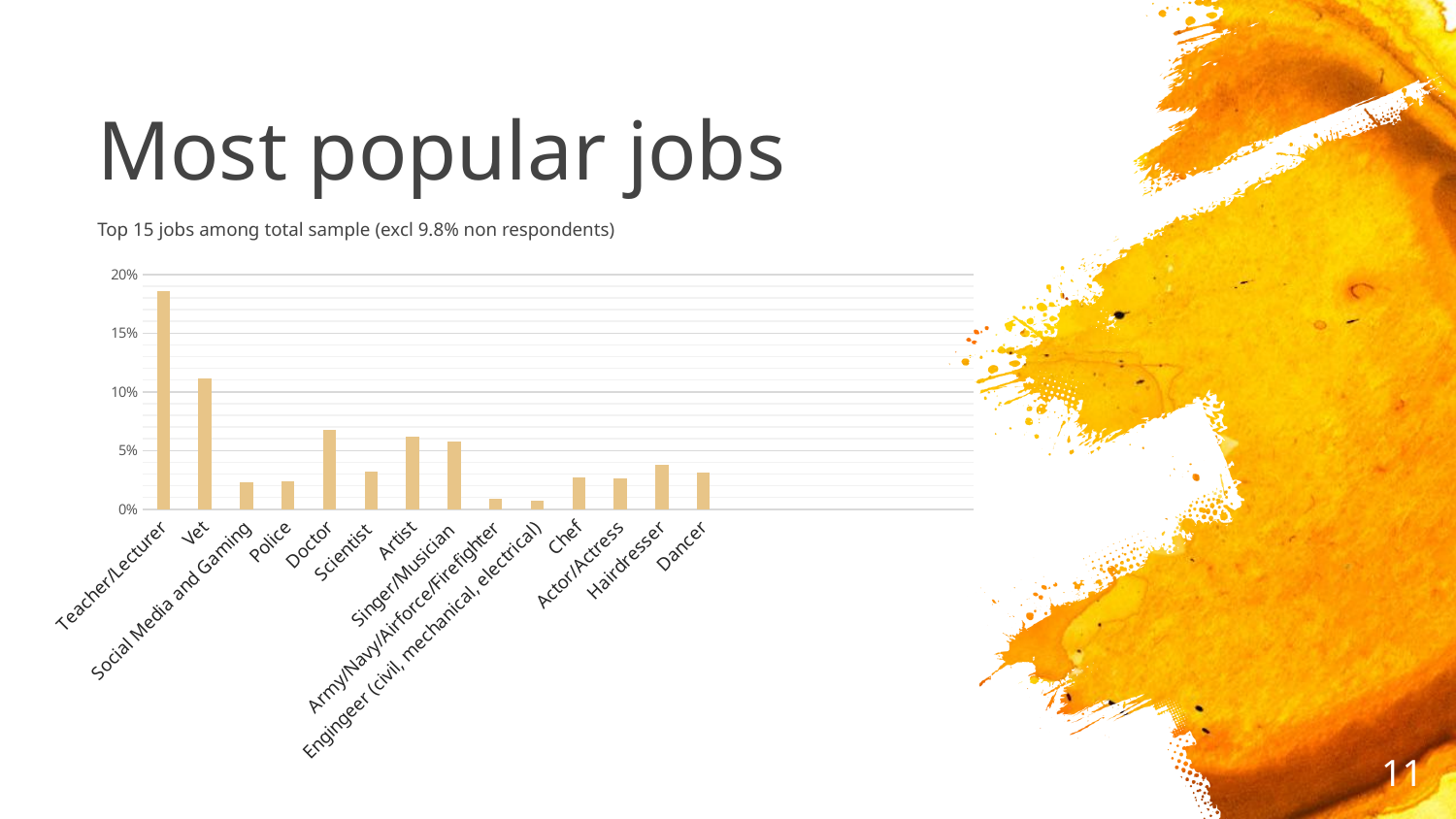
Which is larger, the value for Doctor or the value for Police? Doctor Is the value for Doctor greater or less than 5%? greater Which is larger, the value for Hairdresser or the value for Chef? Hairdresser Which job has the highest value in the chart? Teacher/Lecturer What is the title of the slide containing the chart? Most popular jobs Is the value for Police greater or less than 5%? less What kind of chart is shown on the slide? bar chart Is the value for Teacher/Lecturer greater or less than 15%? greater Which is larger, the value for Teacher/Lecturer or the value for Vet? Teacher/Lecturer